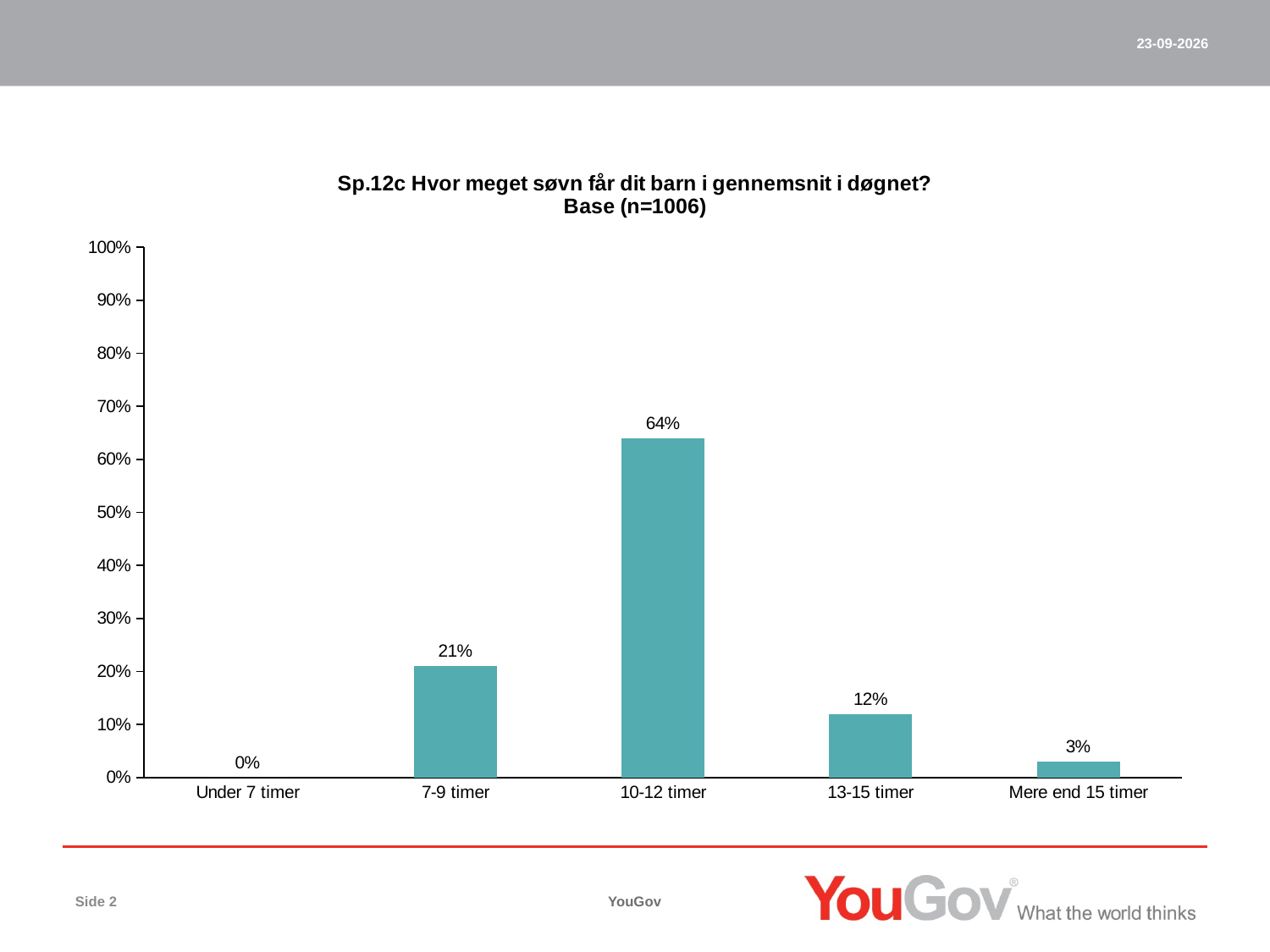
What is the value for Mere end 15 timer? 3% What is the value for 7-9 timer? 21% Which category has the highest value? 10-12 timer What is the difference between the values for 10-12 timer and 7-9 timer? 43% What kind of chart is shown? bar chart What is the base size (n) stated in the chart title? 1006 What is the value for 10-12 timer? 64% How many categories are shown on the x axis? 5 Which is larger, the value for 13-15 timer or the value for Mere end 15 timer? 13-15 timer Is the value for 10-12 timer greater or less than 50%? greater What is the value for 13-15 timer? 12% Which category has the lowest value? Under 7 timer